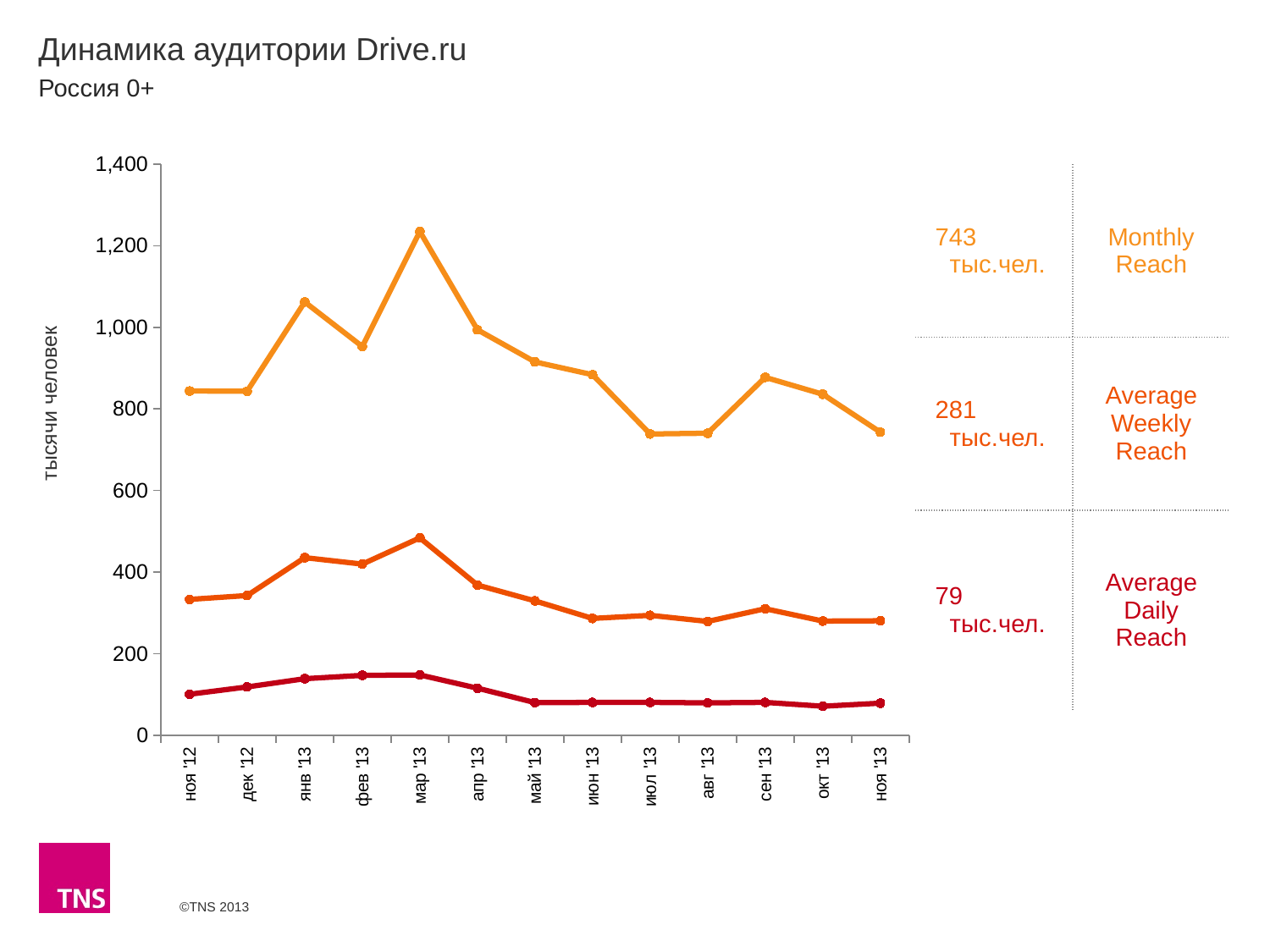
Is the Average Weekly Reach value for мар '13 greater or less than 400? greater Is the Monthly Reach value for ноя '12 greater or less than 1,000? less What kind of chart is shown on the slide? line chart What is the label on the y axis of the chart? тысячи человек How many months are plotted along the x axis? 13 Does the Monthly Reach line rise or fall from мар '13 to июл '13? fall What Average Daily Reach value is printed in the panel next to the chart? 79 тыс.чел. Which is higher for Monthly Reach: янв '13 or фев '13? янв '13 What Monthly Reach value is printed in the panel next to the chart? 743 тыс.чел. In which month does the Monthly Reach line reach its highest point? мар '13 How many lines (series) are plotted on the chart? 3 Is the Monthly Reach value for мар '13 greater or less than 1,200? greater